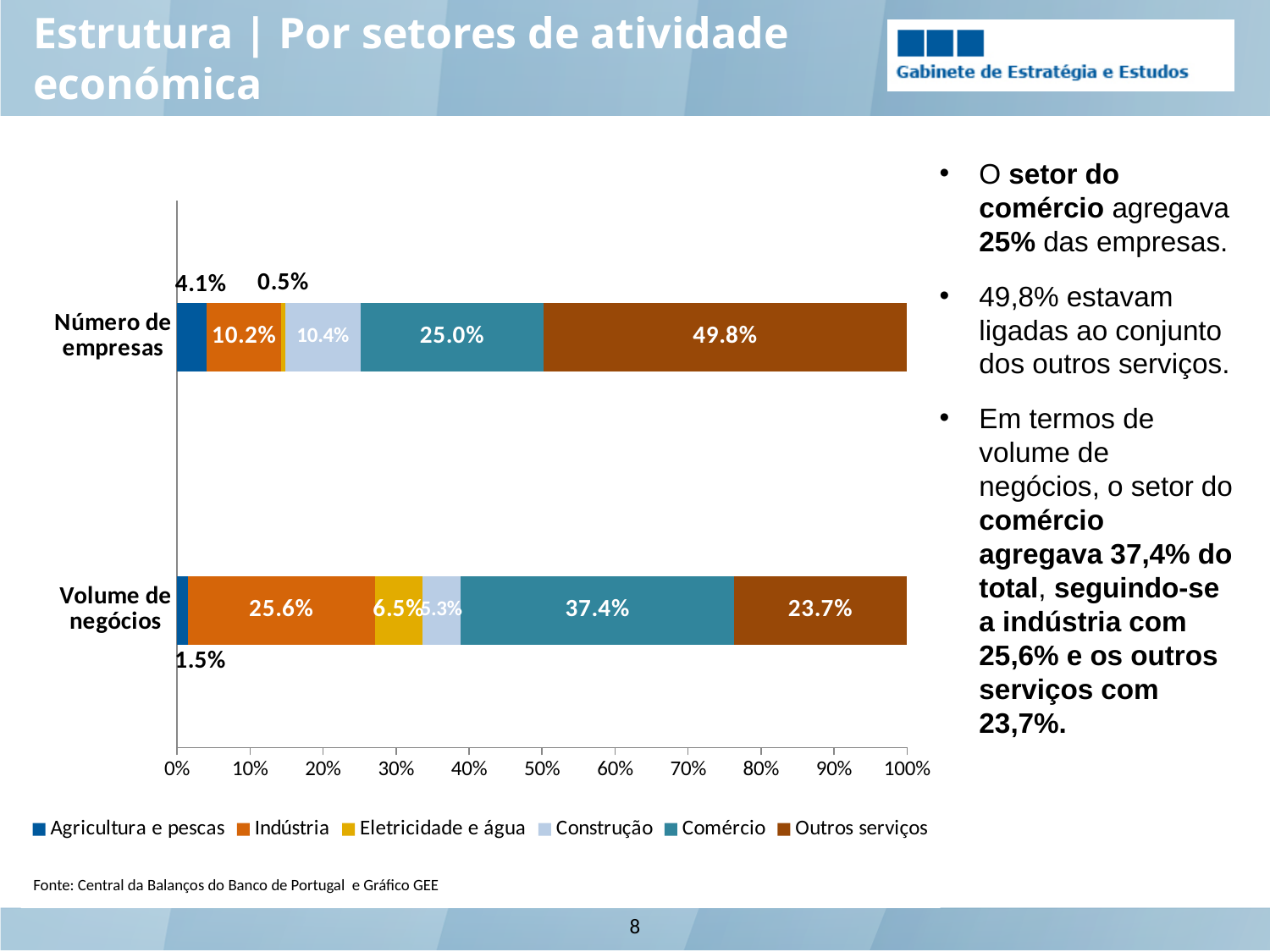
How many categories (bars) are plotted on the chart? 2 What is the value for Outros serviços in the Número de empresas bar? 49.8% What is the value for Eletricidade e água in the Número de empresas bar? 0.5% Which series has the largest share in the Volume de negócios bar? Comércio What is the value for Agricultura e pescas in the Volume de negócios bar? 1.5% Which is larger: Outros serviços in Número de empresas or Outros serviços in Volume de negócios? Número de empresas What is the difference between the Comércio values for Volume de negócios and Número de empresas? 12.4% Which series has the smallest share in the Número de empresas bar? Eletricidade e água What kind of chart is shown on the slide? Stacked bar chart How many series does the legend list? 6 What is the value for Indústria in the Volume de negócios bar? 25.6% What is the value for Comércio in the Número de empresas bar? 25.0%